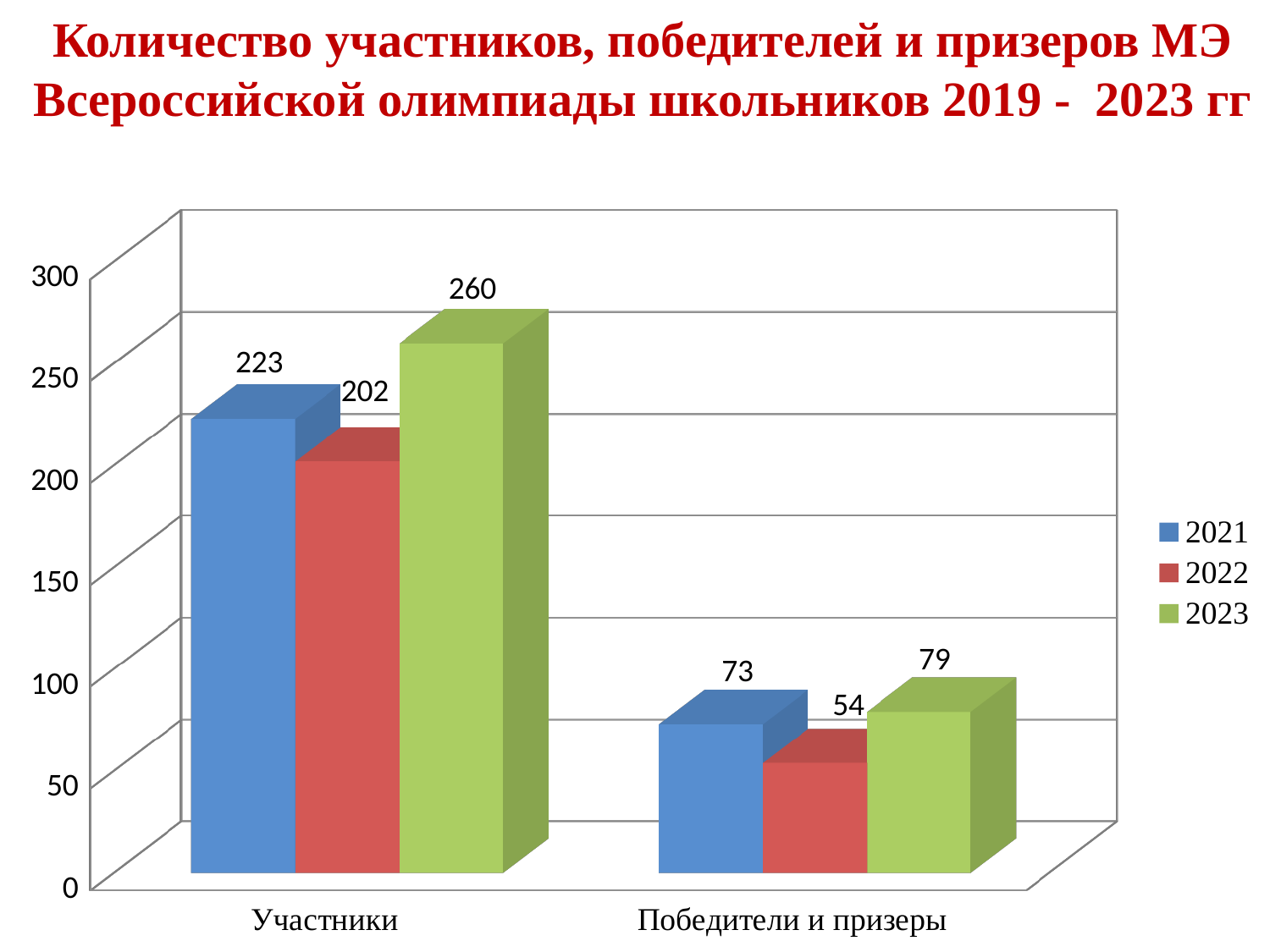
Which year has the lowest value in the Победители и призеры category? 2022 What is the value for 2022 in the Победители и призеры category? 54 What is the difference between the 2023 and 2022 values in the Участники category? 58 What is the difference between the 2021 and 2022 values in the Победители и призеры category? 19 What is the value for 2023 in the Участники category? 260 How many series does the legend list? 3 What is the value for 2021 in the Участники category? 223 Which year has the highest value in the Участники category? 2023 Which is larger in the Победители и призеры category: the value for 2021 or for 2023? 2023 How many categories are shown on the x axis? 2 What kind of chart is shown on the slide? bar chart Is the value for 2022 in the Участники category greater or less than 250? less